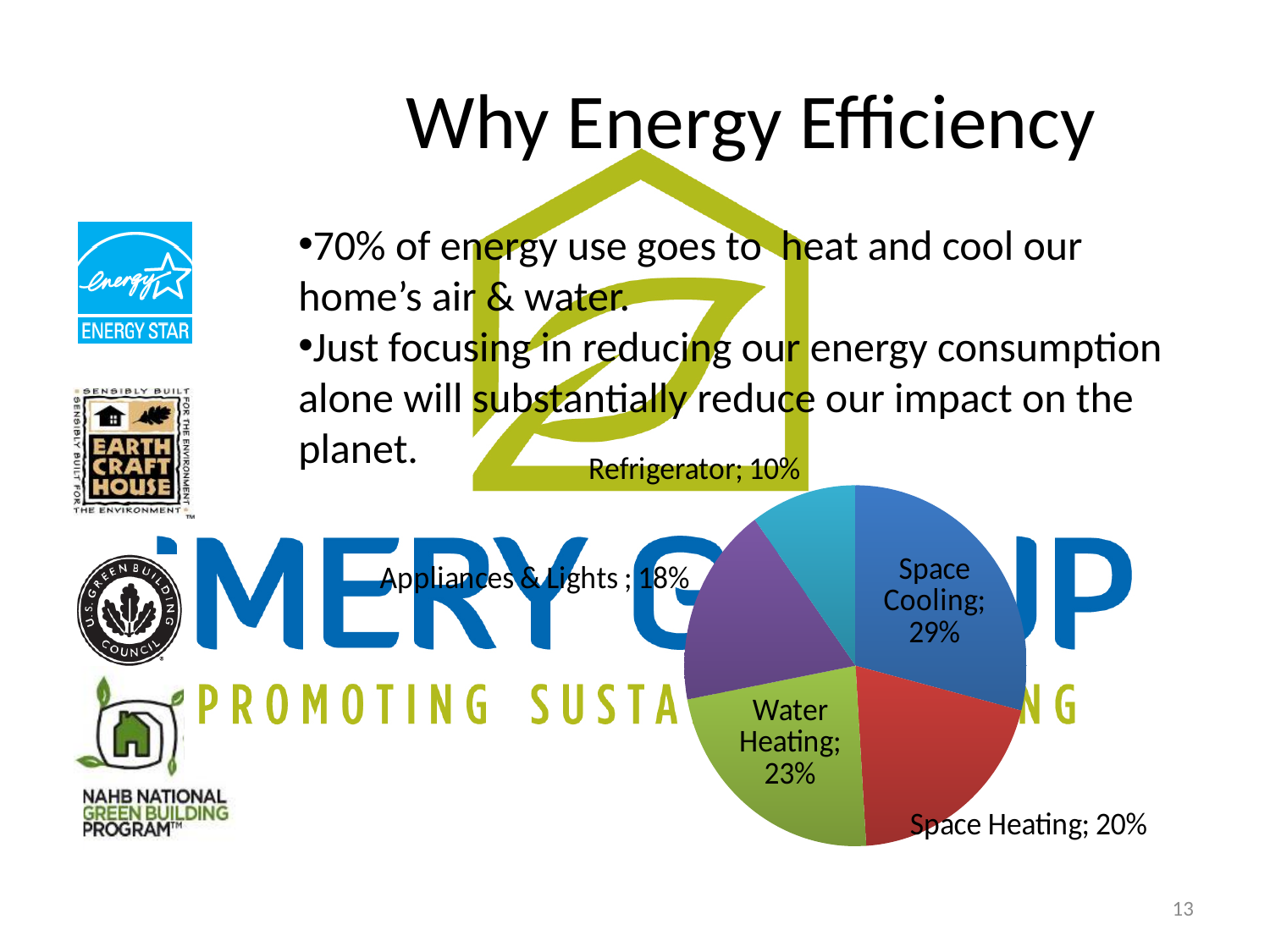
What is the difference in percentage points between Space Cooling and Space Heating in the pie chart? 9 What percentage of the pie chart is Appliances & Lights? 18% What percentage of the pie chart is Water Heating? 23% What colour is the Space Cooling slice in the pie chart? blue Which slice of the pie chart is the largest? Space Cooling What percentage of the pie chart is Space Heating? 20% What kind of chart is shown on the slide? pie chart How many slices does the pie chart have? 5 What percentage of the pie chart is Refrigerator? 10% What percentage of the pie chart is Space Cooling? 29% Which is larger in the pie chart, Water Heating or Appliances & Lights? Water Heating Which slice of the pie chart is the smallest? Refrigerator